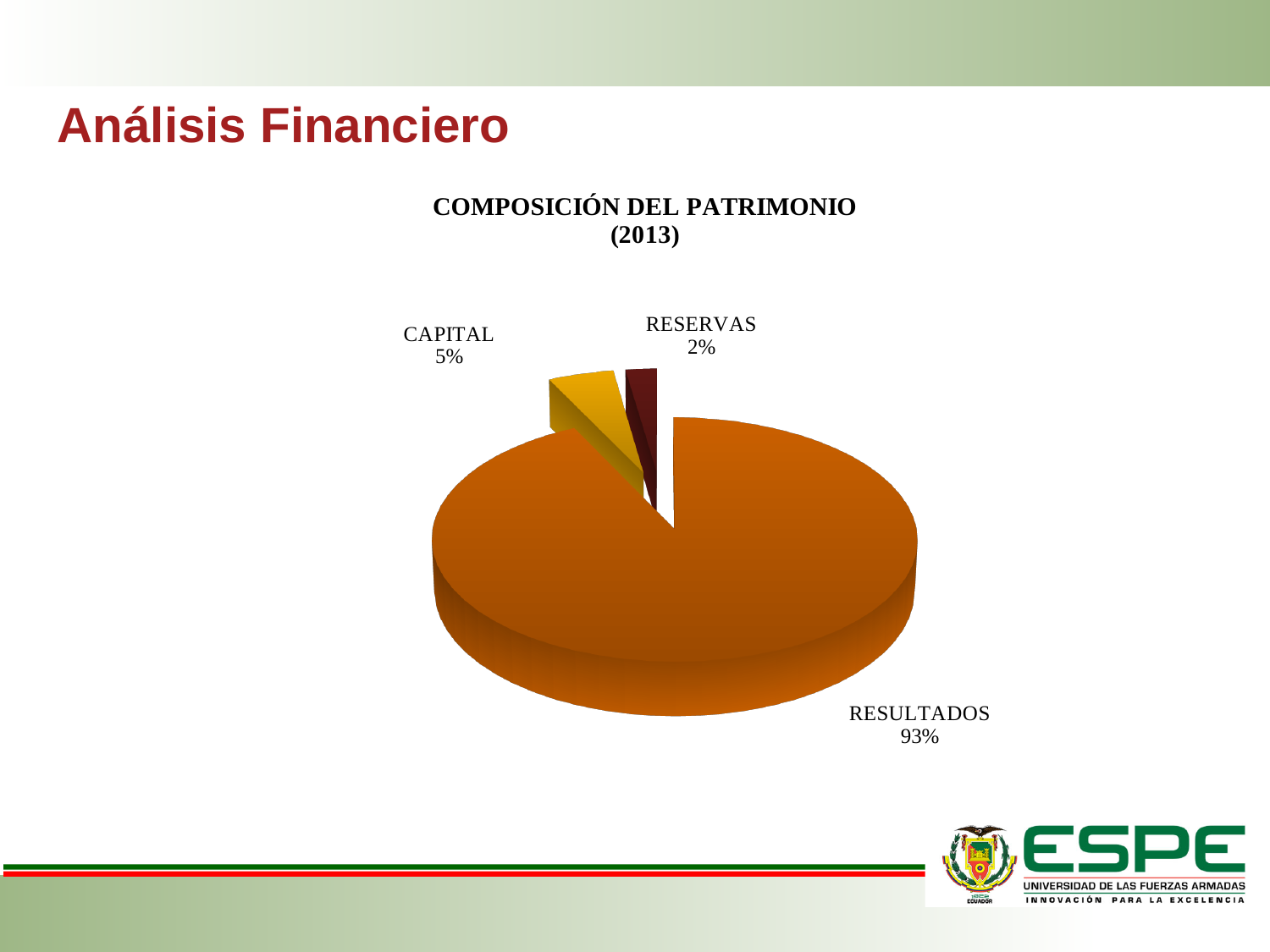
What is the title of the chart? COMPOSICIÓN DEL PATRIMONIO (2013) What share of the pie does CAPITAL represent? 5% Which category has the largest slice of the pie? RESULTADOS What colour is the RESULTADOS slice? Orange How many categories are shown in the pie chart? 3 What is the difference in percentage points between CAPITAL and RESERVAS? 3 What share of the pie does RESERVAS represent? 2% What kind of chart is shown on the slide? Pie chart Which is larger, the share for CAPITAL or the share for RESERVAS? CAPITAL What share of the pie does RESULTADOS represent? 93% What is the difference in percentage points between RESULTADOS and CAPITAL? 88 Which category has the smallest slice of the pie? RESERVAS